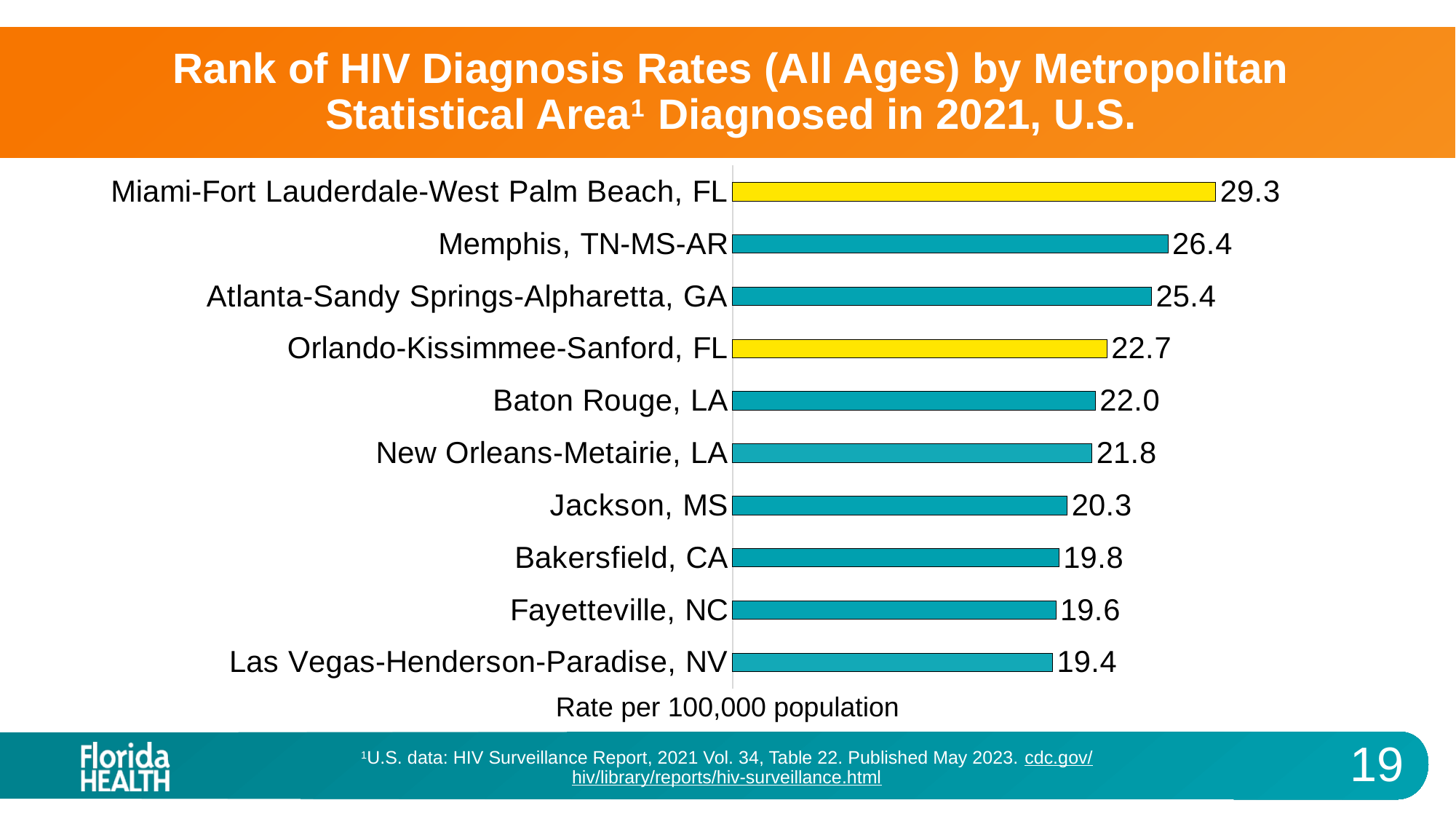
What kind of chart is shown on the slide? Bar chart Which has a higher HIV diagnosis rate, Bakersfield, CA or Fayetteville, NC? Bakersfield, CA What is the HIV diagnosis rate for Orlando-Kissimmee-Sanford, FL? 22.7 How many metropolitan statistical areas are shown in the chart? 10 What is the difference between the rates for Miami-Fort Lauderdale-West Palm Beach, FL and Orlando-Kissimmee-Sanford, FL? 6.6 Which has a higher HIV diagnosis rate, Memphis, TN-MS-AR or Atlanta-Sandy Springs-Alpharetta, GA? Memphis, TN-MS-AR Which metropolitan statistical area has the lowest HIV diagnosis rate? Las Vegas-Henderson-Paradise, NV Which metropolitan statistical area has the highest HIV diagnosis rate? Miami-Fort Lauderdale-West Palm Beach, FL What is the HIV diagnosis rate for Memphis, TN-MS-AR? 26.4 What is the difference between the rates for Atlanta-Sandy Springs-Alpharetta, GA and Baton Rouge, LA? 3.4 What is the HIV diagnosis rate for Jackson, MS? 20.3 What unit is the rate expressed in, according to the axis label? Rate per 100,000 population